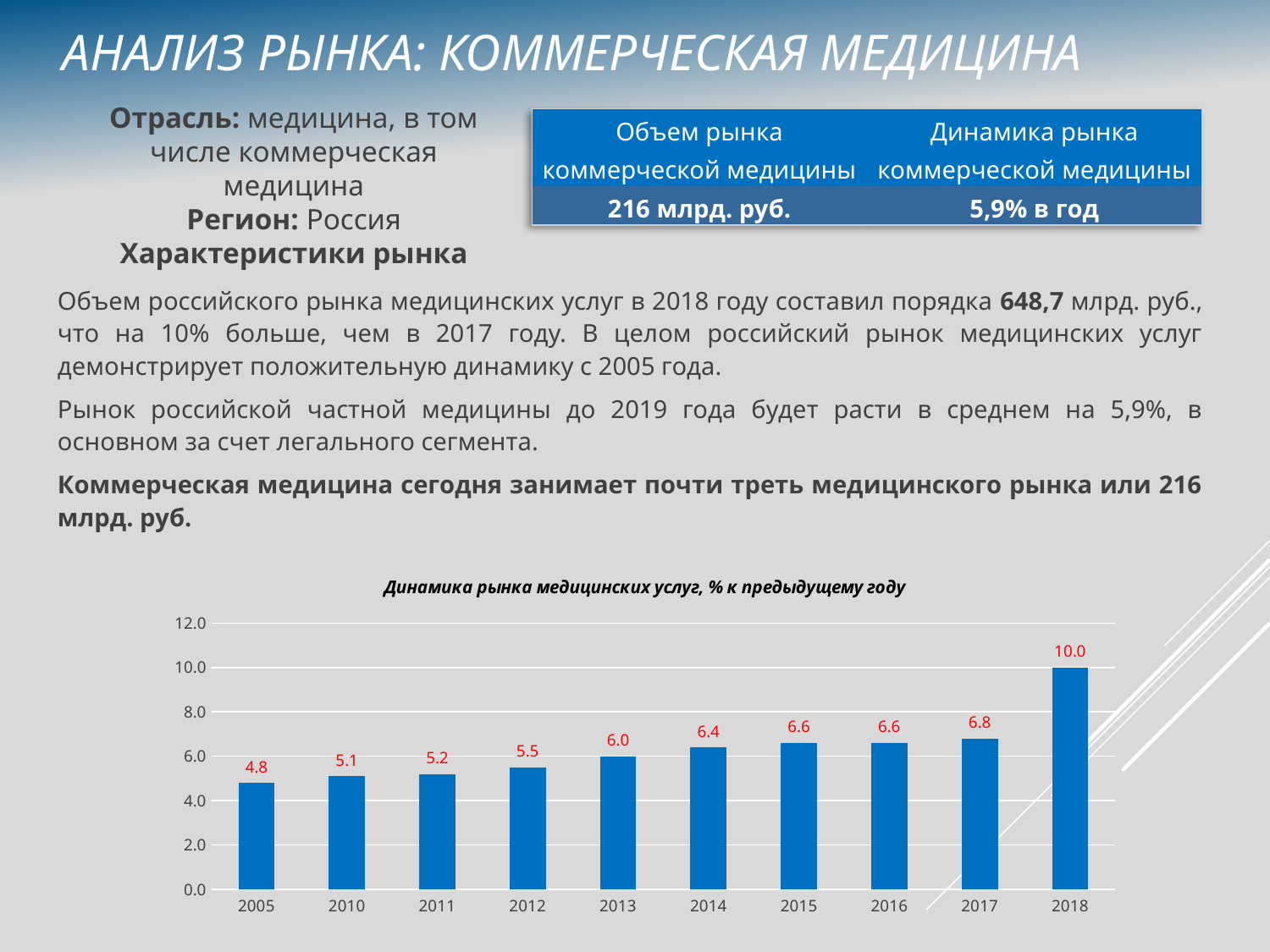
Which year has the highest value in the chart? 2018 Do the values generally rise or fall from 2005 to 2018? rise Which is larger, the value for 2012 or the value for 2014? 2014 How many years are shown on the x axis of the chart? 10 What kind of chart is shown on the slide? bar chart What is the difference between the values for 2018 and 2017? 3.2 Which year has the lowest value in the chart? 2005 What is the value for 2013 in the chart? 6.0 What is the value for 2005 in the chart? 4.8 What is the title of the chart? Динамика рынка медицинских услуг, % к предыдущему году What is the value for 2018 in the chart? 10.0 Is the value for 2016 greater or less than 8.0? less